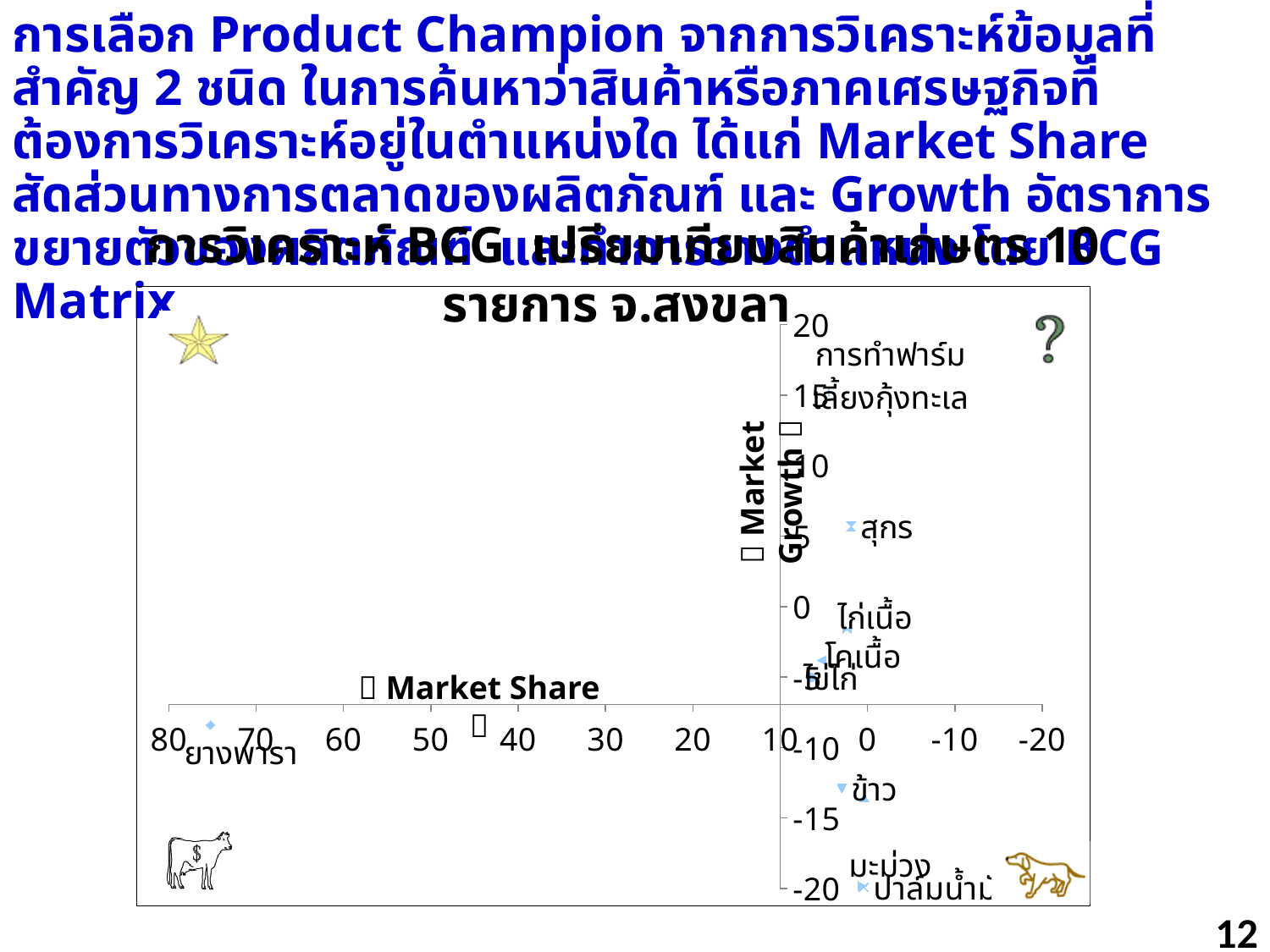
What is the label of the vertical axis of the chart? Market Growth What is the label of the horizontal axis of the chart? Market Share Which product has the highest Market Growth in the chart? การทำฟาร์มเลี้ยงกุ้งทะเล Is the Market Growth value for สุกร greater or less than 0? greater Which has the larger Market Share, ยางพารา or ข้าว? ยางพารา Which has the higher Market Growth, สุกร or ข้าว? สุกร Is the Market Growth value for ปาล์มน้ำมัน greater or less than -15? less Is the Market Growth value for ข้าว greater or less than -10? less Which product has the highest Market Share in the chart? ยางพารา What kind of chart is shown on the slide? scatter chart